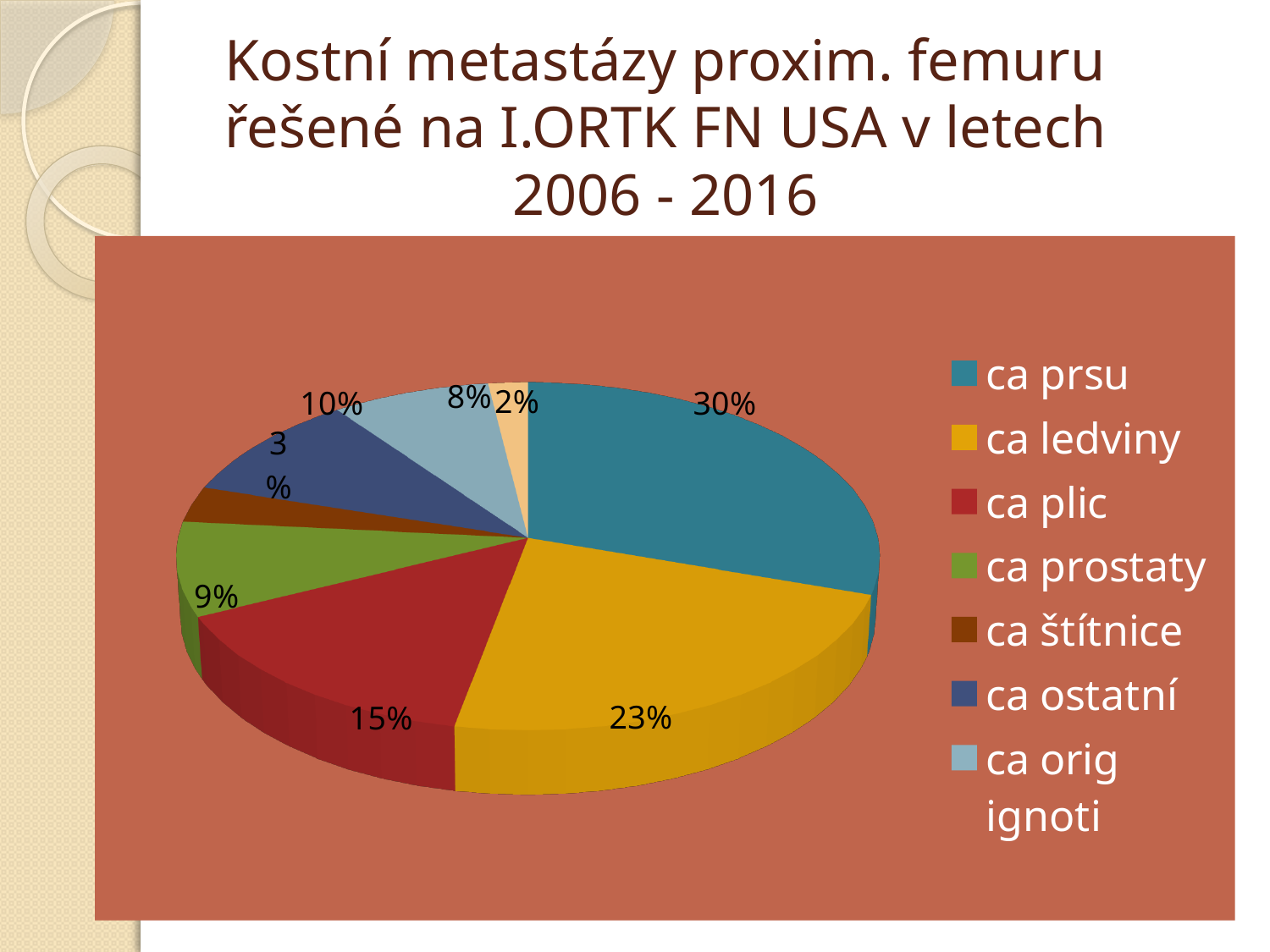
How many entries does the legend list? 7 What share of the pie does "ca orig ignoti" represent? 8% What percentage is shown for "ca štítnice"? 3% What percentage is shown for "ca ostatní"? 10% Which has a larger share, "ca plic" or "ca ostatní"? ca plic What type of chart is shown on the slide? pie chart What share of the pie does "ca prsu" represent? 30% What percentage is shown for "ca ledviny"? 23% What percentage is shown for "ca plic"? 15% How many percentage points larger is the share of "ca prsu" than that of "ca ledviny"? 7 What share of the pie does "ca prostaty" represent? 9% Which category has the largest share of the pie? ca prsu